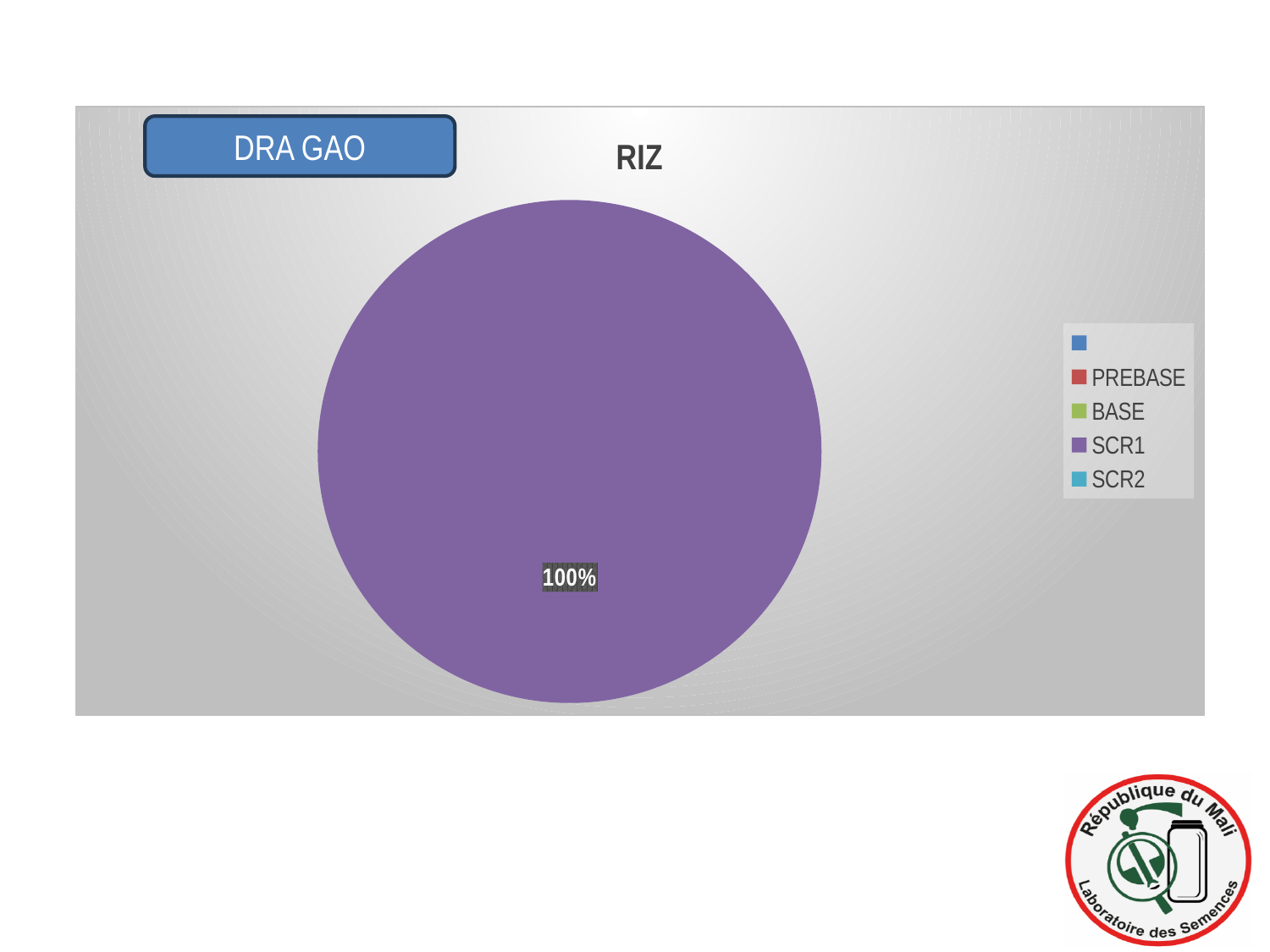
Which category has the largest share of the pie chart? SCR1 Which is larger in the pie chart, SCR1 or PREBASE? SCR1 How many labelled entries does the legend list? 4 What share of the pie does SCR1 account for? 100% How many slices are visible in the pie chart? 1 What percentage is shown for the SCR1 slice of the pie chart? 100% What is the title of the pie chart? RIZ What kind of chart is shown on the slide? pie chart What colour is the SCR1 slice in the pie chart? purple Is the share for SCR1 greater or less than 50%? greater